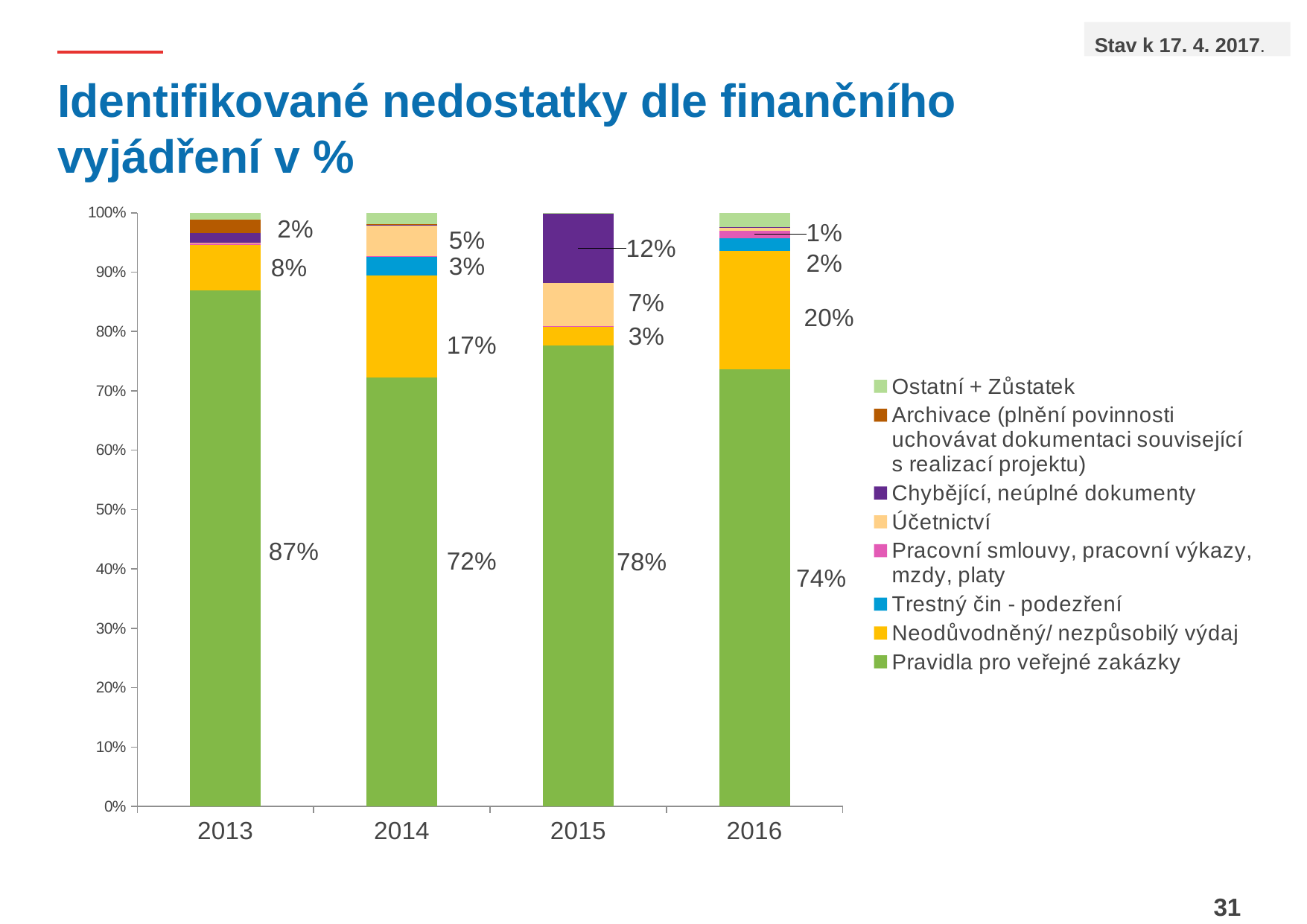
What is the value for Chybějící, neúplné dokumenty in 2015? 12% What is the value for Účetnictví in 2015? 7% Which year has the larger share for Neodůvodněný/ nezpůsobilý výdaj, 2014 or 2016? 2016 What is the value for Neodůvodněný/ nezpůsobilý výdaj in 2016? 20% In which year is the share of Pravidla pro veřejné zakázky the lowest? 2014 How many years are shown on the x axis of the chart? 4 What is the difference between the Pravidla pro veřejné zakázky share in 2013 and in 2014? 15 percentage points What kind of chart is shown on the slide? Stacked bar chart How many series does the chart legend list? 8 Is the value for Pravidla pro veřejné zakázky in 2015 greater or less than 70%? greater What is the value for Pravidla pro veřejné zakázky in 2013? 87% In which year is the share of Pravidla pro veřejné zakázky the highest? 2013